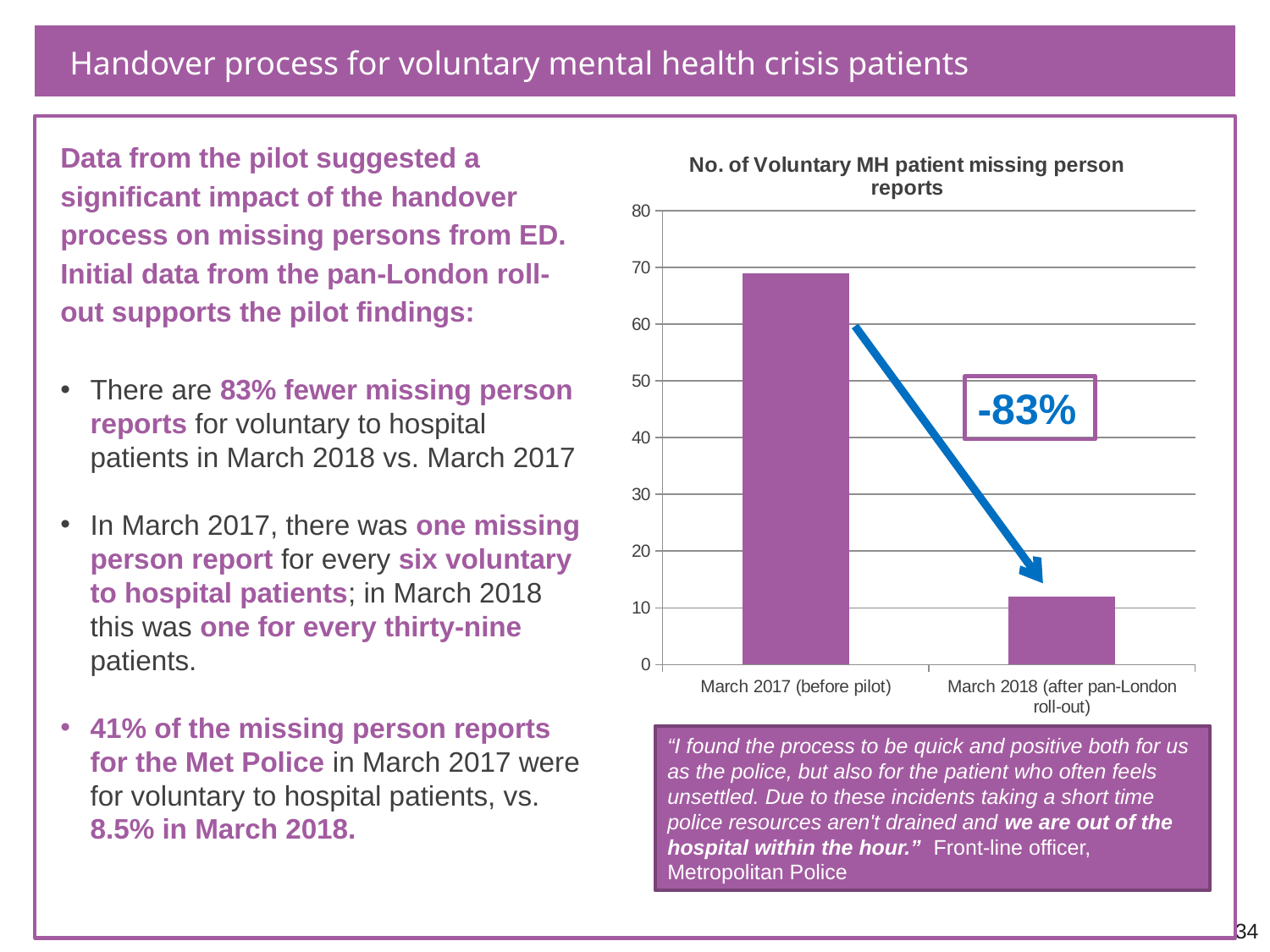
Do the values rise or fall from March 2017 to March 2018 along the x axis? fall What percentage change is annotated on the chart between the two bars? -83% Which category has the highest value in the chart? March 2017 (before pilot) What is the maximum value shown on the chart's vertical axis? 80 Is the value for March 2017 (before pilot) greater or less than 60? greater How many bars does the chart show? 2 What is the title of the chart? No. of Voluntary MH patient missing person reports What kind of chart is shown on the slide? bar chart Which is larger, the value for March 2017 (before pilot) or March 2018 (after pan-London roll-out)? March 2017 (before pilot) Which category has the lowest value in the chart? March 2018 (after pan-London roll-out) Is the value for March 2018 (after pan-London roll-out) greater or less than 20? less